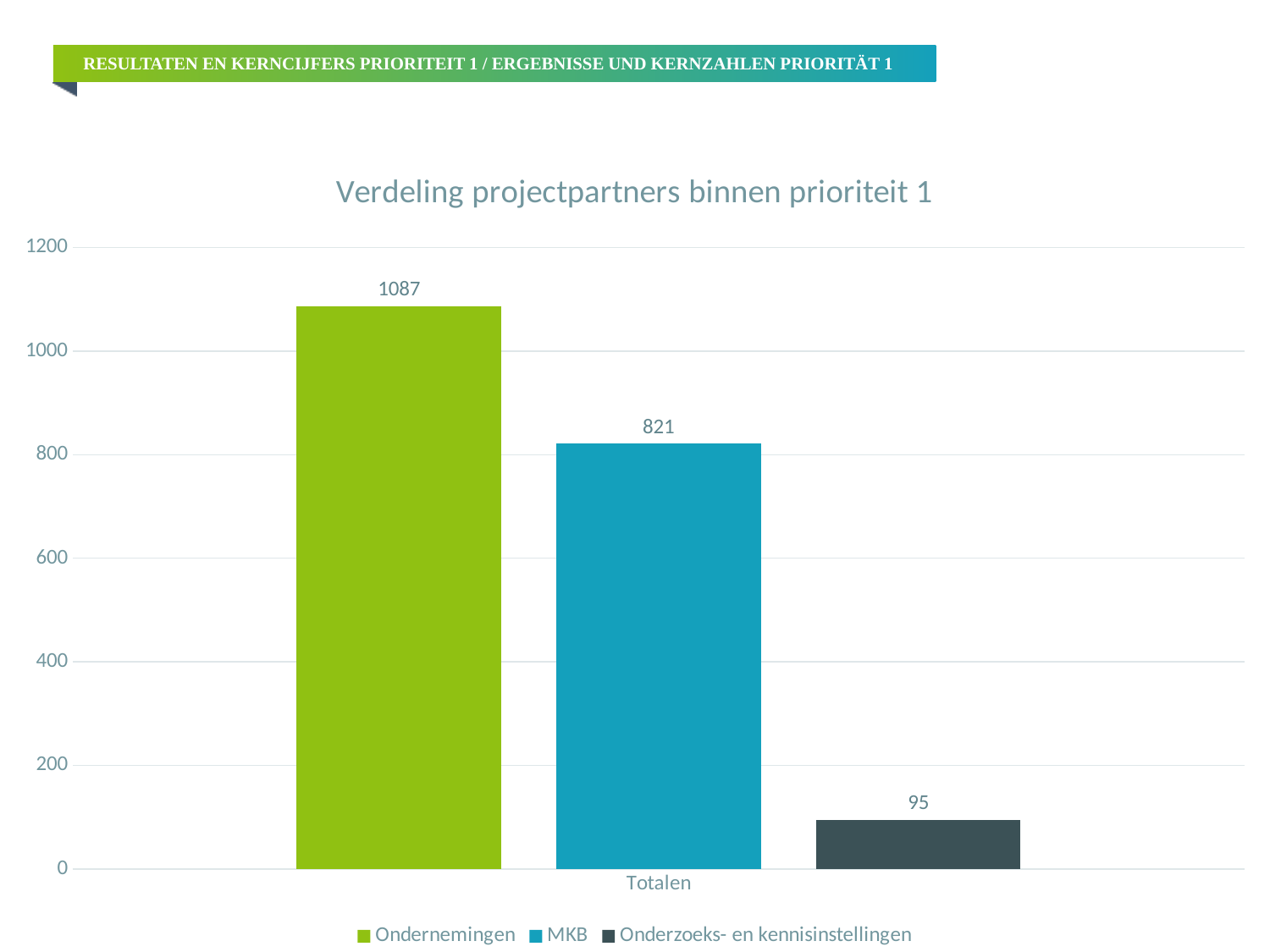
Which series has the highest value? Ondernemingen What is the difference between the values for MKB and Onderzoeks- en kennisinstellingen? 726 Which series has the lowest value? Onderzoeks- en kennisinstellingen What kind of chart is shown on the slide? bar chart What is the title of the chart? Verdeling projectpartners binnen prioriteit 1 Which is larger, the value for MKB or the value for Onderzoeks- en kennisinstellingen? MKB What is the difference between the values for Ondernemingen and MKB? 266 Is the value for MKB greater or less than 1000? less What is the value for MKB? 821 How many series does the legend list? 3 What is the value for Onderzoeks- en kennisinstellingen? 95 What is the value for Ondernemingen? 1087